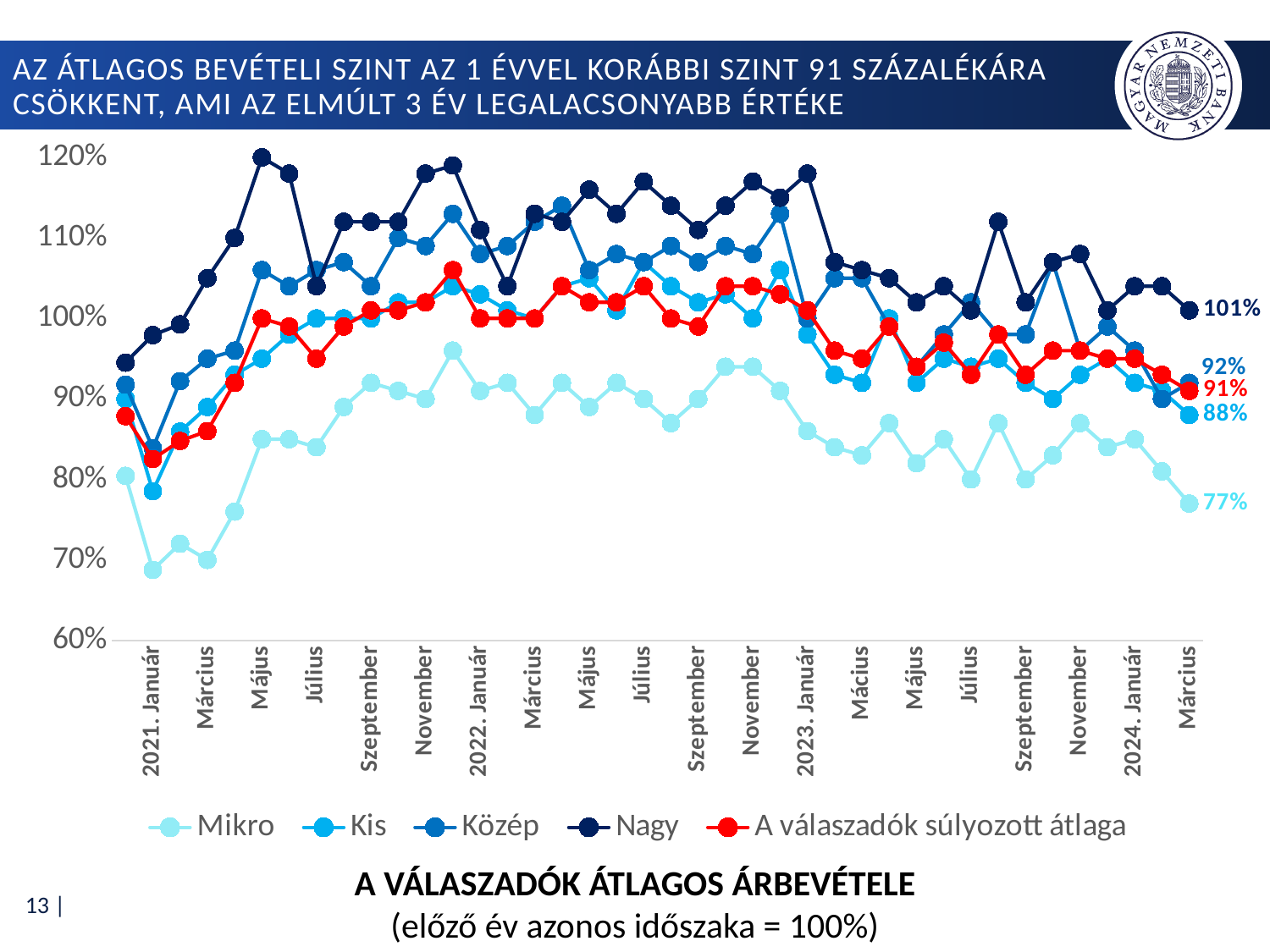
What kind of chart is shown on the slide? line chart At the last point (Március 2024), how many percentage points higher is Nagy than Mikro? 24 percentage points What is the value of 'A válaszadók súlyozott átlaga' at the last point (Március 2024)? 91% At the last point (Március 2024), which is larger: Kis or Közép? Közép Is the value of the Nagy series at 2021. Január greater or less than 100%? less Which series has the highest value at the last point (Március 2024)? Nagy What is the value of the Kis series at the last point (Március 2024)? 88% Which series is drawn in red? A válaszadók súlyozott átlaga What is the value of the Nagy series at the last point (Március 2024)? 101% Which series has the lowest value at the last point (Március 2024)? Mikro What is the value of the Mikro series at the last point (Március 2024)? 77% How many series does the legend list? 5